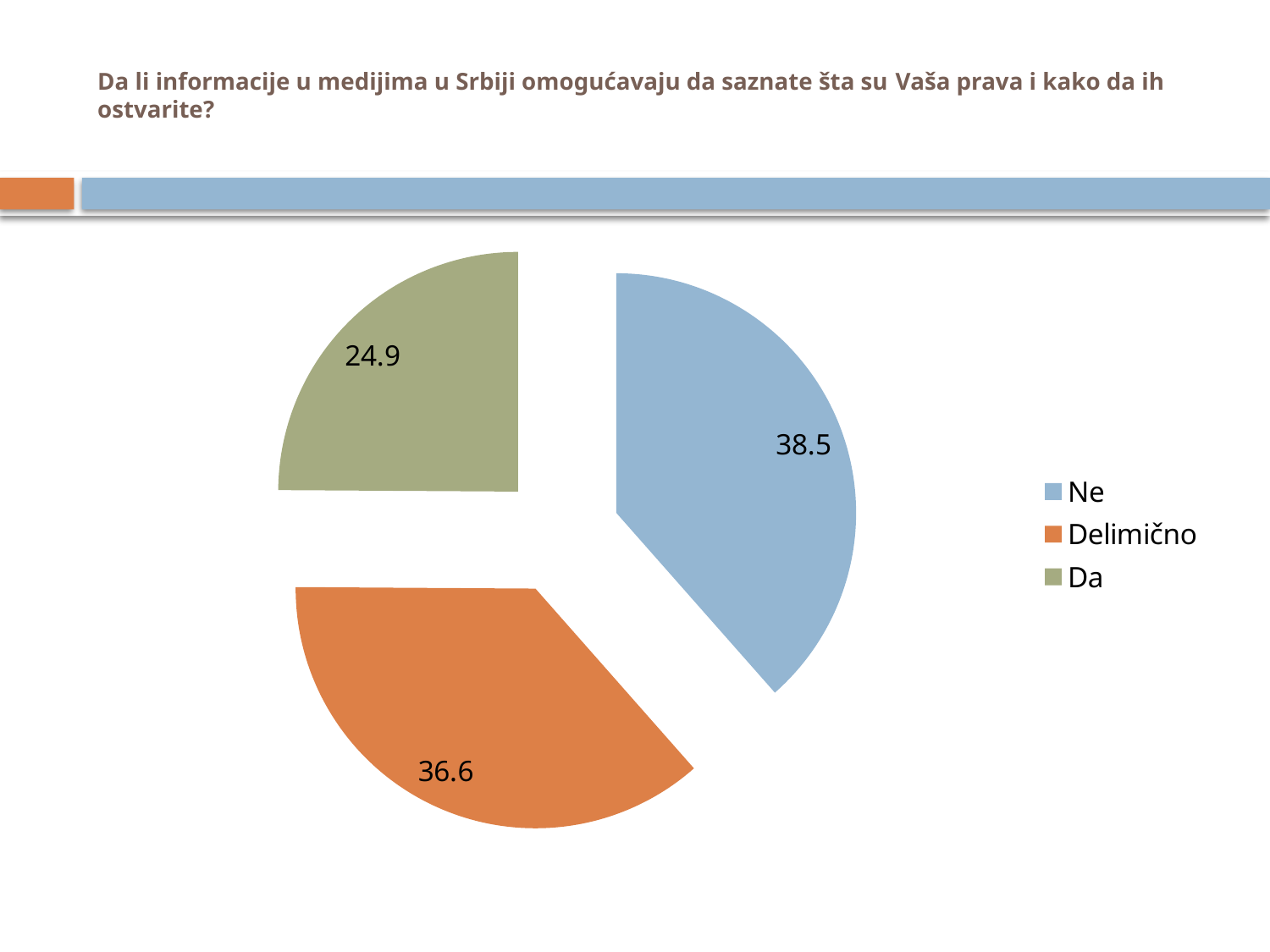
Which category has the smallest slice in the pie chart? Da What is the value for Delimično in the pie chart? 36.6 Which colour represents Delimično in the legend? Orange What is the value for Da in the pie chart? 24.9 What is the difference between the values for Ne and Delimično? 1.9 What share of the pie does the Da slice represent? 24.9 Which is larger, the value for Delimično or the value for Da? Delimično What kind of chart is shown on the slide? Pie chart How many slices does the pie chart have? 3 Which category has the largest slice in the pie chart? Ne What is the difference between the values for Delimično and Da? 11.7 What is the value for Ne in the pie chart? 38.5